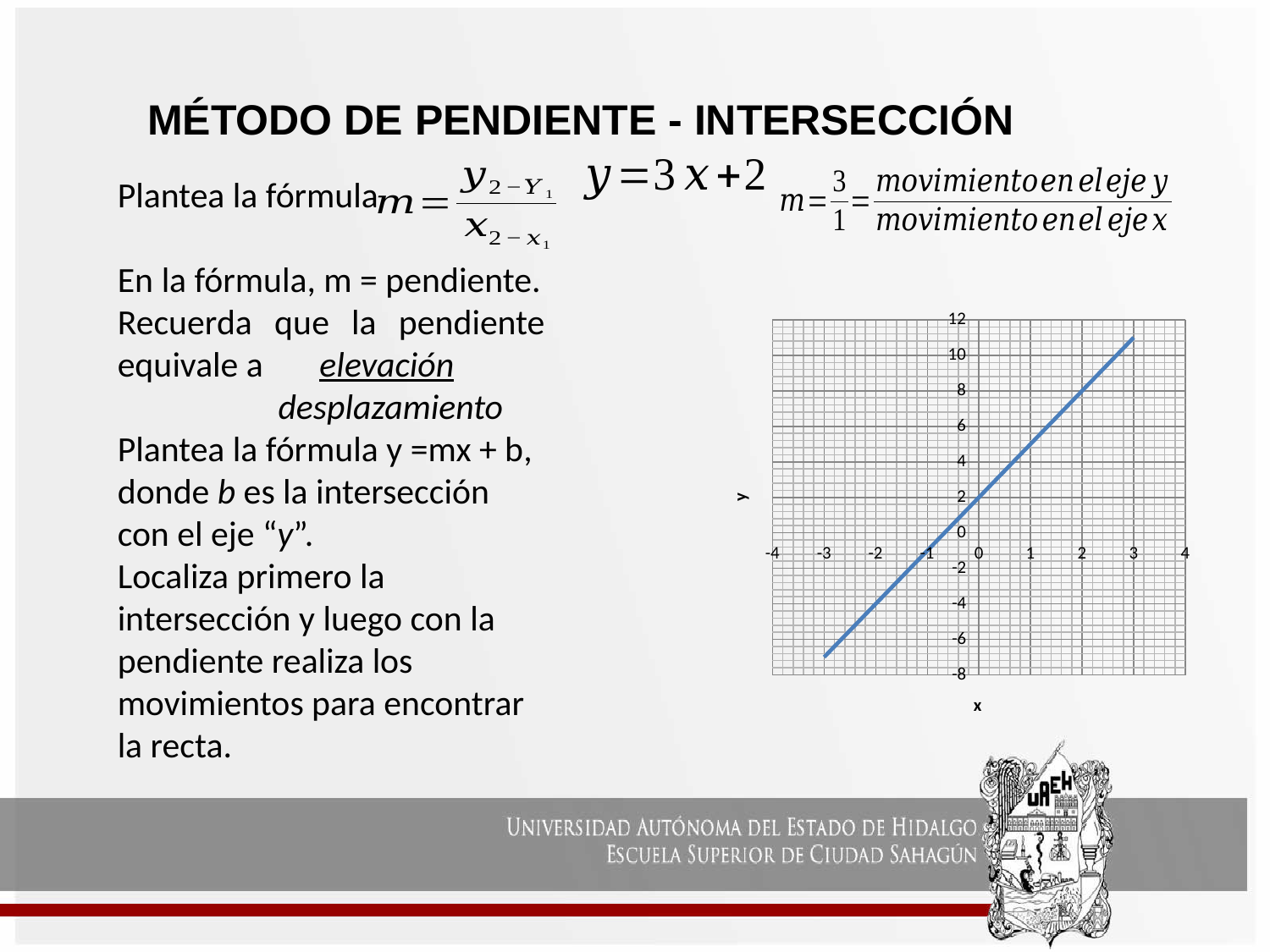
What is the highest tick value shown on the y axis? 12 Is the value of the line at x = 1 greater or less than 4? greater Is the value of the line at x = 3 greater or less than 10? greater Is the value of the line at x = -3 greater or less than -6? less Which is larger, the value of the line at x = 3 or at x = -3? x = 3 How many lines are plotted on the chart? 1 At which end of the plotted line, left or right, is the y value highest? right Does the plotted line rise or fall as x increases? rises What is the label on the horizontal axis of the chart? x What kind of chart is shown on the slide? line chart At what y value does the plotted line cross the y axis? 2